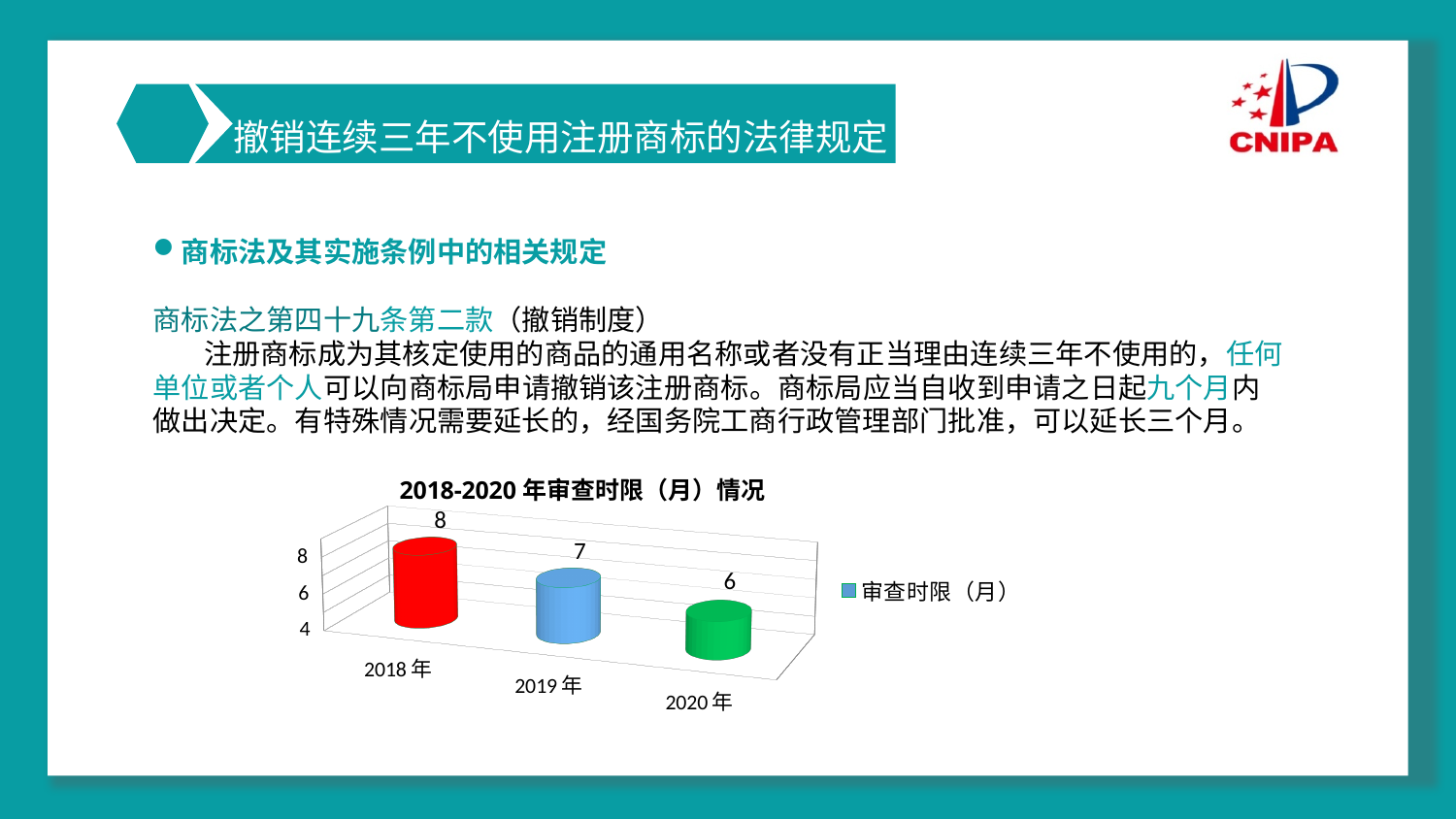
Which is larger, the value for 2019 年 or the value for 2020 年? 2019 年 What is the value for 2018 年 in the chart? 8 How many categories are shown in the chart? 3 Which year has the highest value in the chart? 2018 年 What is the difference between the values for 2018 年 and 2020 年? 2 What is the value for 2020 年 in the chart? 6 Do the values rise or fall from 2018 年 to 2020 年? fall What kind of chart is shown on the slide? bar chart Which year has the lowest value in the chart? 2020 年 What is the title of the chart? 2018-2020 年审查时限（月）情况 How many series does the legend list? 1 What is the value for 2019 年 in the chart? 7